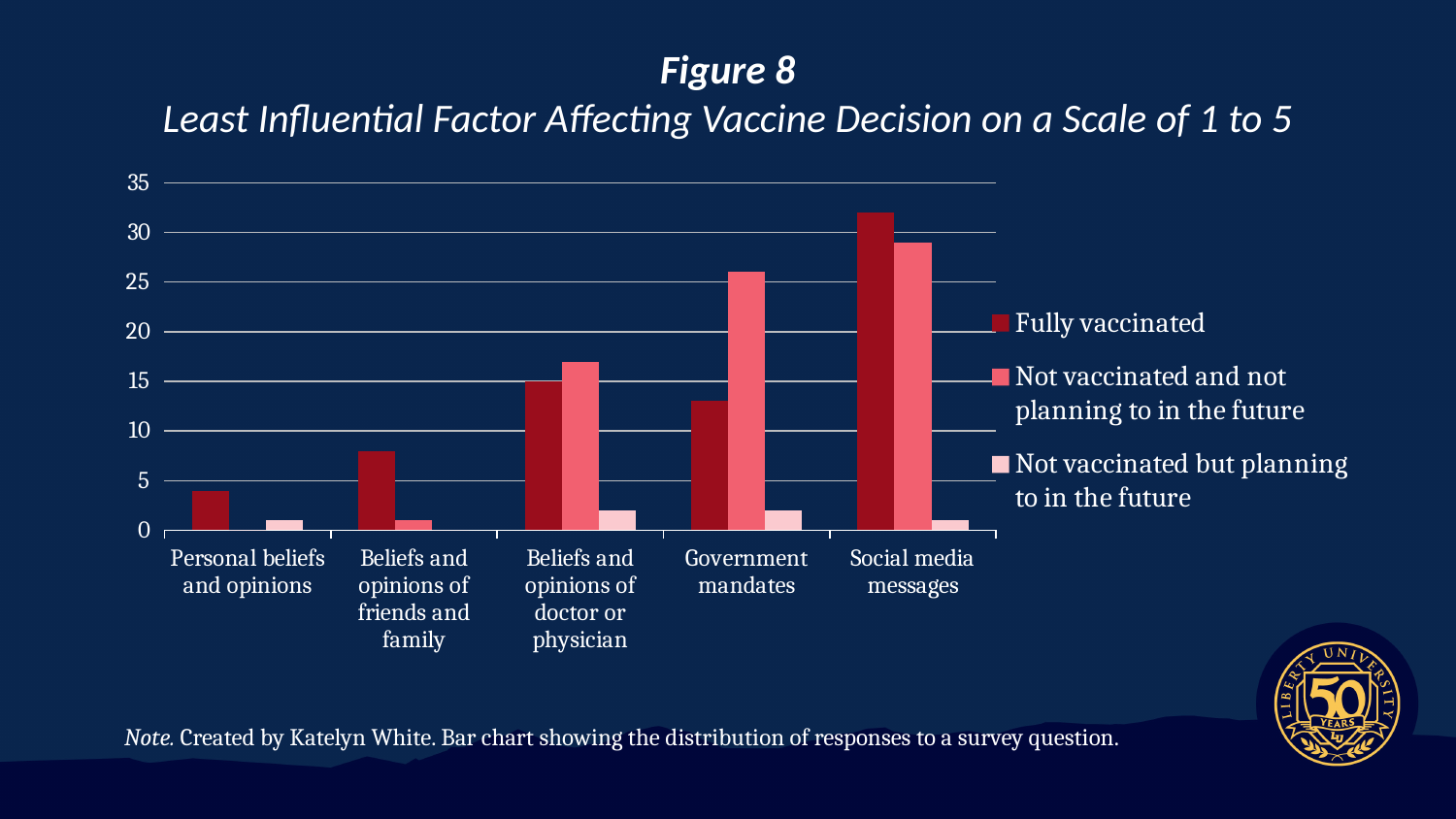
Is the Not vaccinated and not planning to in the future value for Government mandates greater or less than 25? greater How many series does the legend list? 3 Is the Fully vaccinated value for Beliefs and opinions of friends and family greater or less than 10? less For Government mandates, which series has the larger value: Fully vaccinated or Not vaccinated and not planning to in the future? Not vaccinated and not planning to in the future Is the Fully vaccinated value for Social media messages greater or less than 30? greater How many factor categories are shown along the x axis? 5 For the Fully vaccinated series, which category has the highest value? Social media messages What is the figure number given in the chart title? Figure 8 For the Fully vaccinated series, which category has the lowest value? Personal beliefs and opinions What kind of chart is shown on the slide? Bar chart For the Not vaccinated and not planning to in the future series, which category has the highest value? Social media messages Do the values for the Not vaccinated and not planning to in the future series rise or fall from left to right across the categories? rise